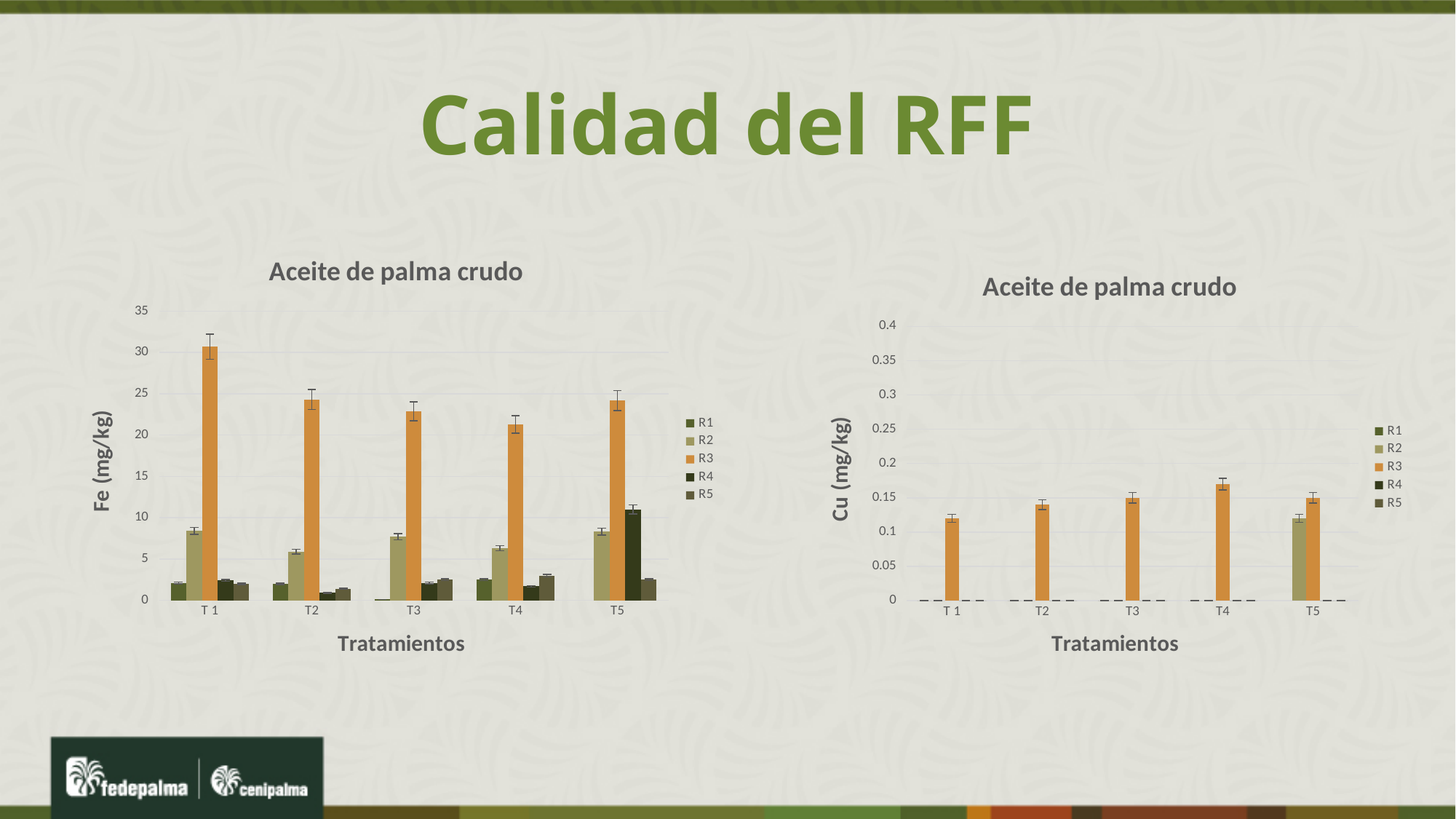
In the right chart (Cu (mg/kg)), is the R3 value for T 1 greater or less than 0.15? less In the right chart (Cu (mg/kg)), is the R3 value for T4 greater or less than 0.15? greater In the left chart (Fe (mg/kg)), is the R3 value for T 1 greater or less than 25? greater In the left chart (Fe (mg/kg)), how many series does the legend list? 5 In the left chart (Fe (mg/kg)), for T 1, which is larger: R2 or R4? R2 In the left chart (Fe (mg/kg)), at which treatment is the R3 bar highest? T 1 In the right chart (Cu (mg/kg)), how many treatment categories are shown on the x axis? 5 What is the y-axis label of the right chart? Cu (mg/kg) What kind of chart is the left chart (Fe (mg/kg))? bar chart In the right chart (Cu (mg/kg)), at which treatment is the R3 bar highest? T4